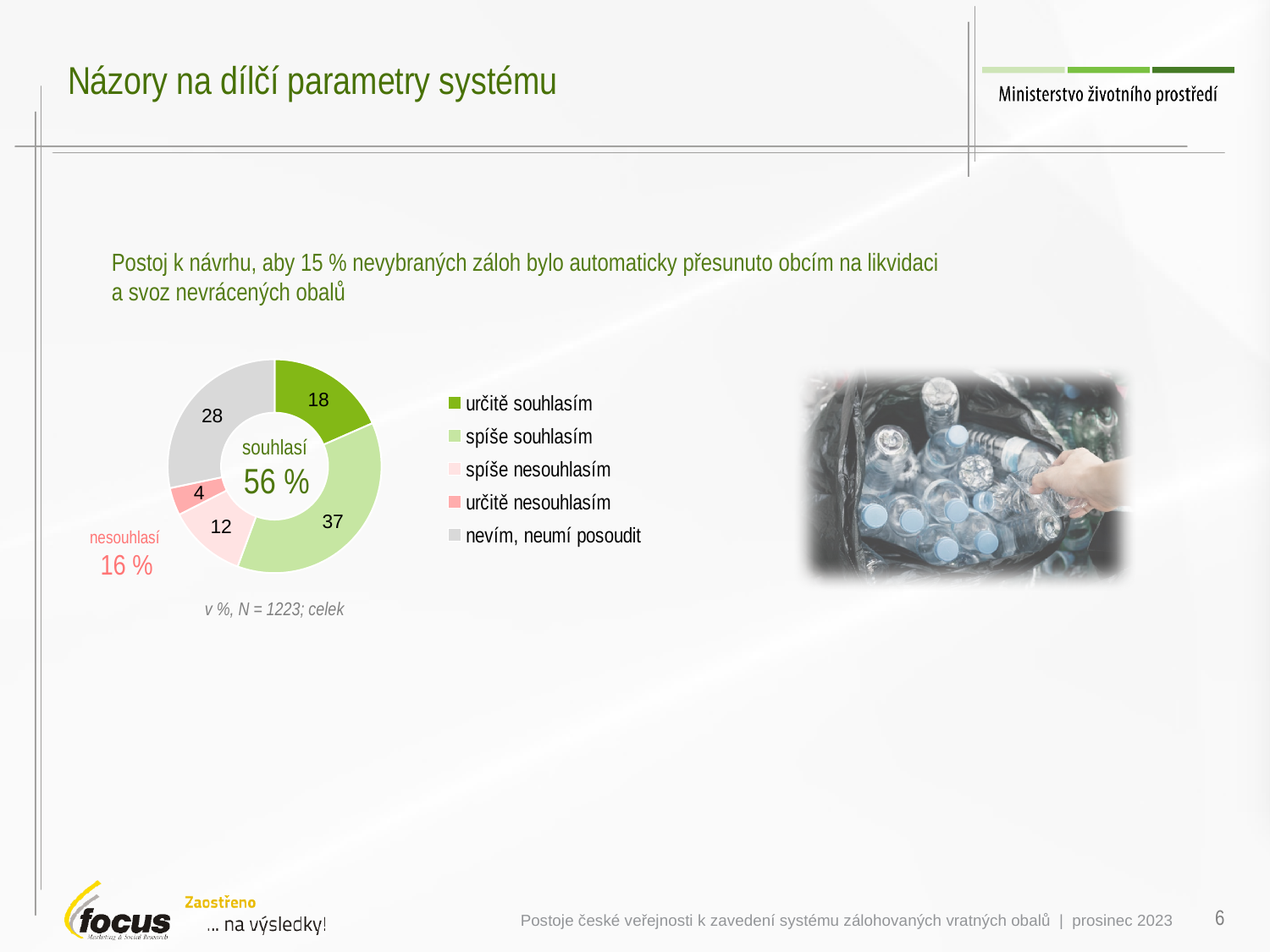
What is the difference between the values for "spíše souhlasím" and "určitě souhlasím"? 19 Which category has the smallest share in the donut chart? určitě nesouhlasím What is the value for "spíše souhlasím" in the donut chart? 37 What is the value for "určitě nesouhlasím" in the donut chart? 4 What is the value for "určitě souhlasím" in the donut chart? 18 What combined percentage is shown for "souhlasí" in the centre of the donut chart? 56 % What type of chart is shown on the slide? Donut (pie) chart How many categories does the legend of the donut chart list? 5 What is the value for "nevím, neumí posoudit" in the donut chart? 28 What combined percentage is shown for "nesouhlasí" next to the donut chart? 16 % Which is larger: the value for "nevím, neumí posoudit" or the value for "spíše nesouhlasím"? nevím, neumí posoudit Which category has the largest share in the donut chart? spíše souhlasím